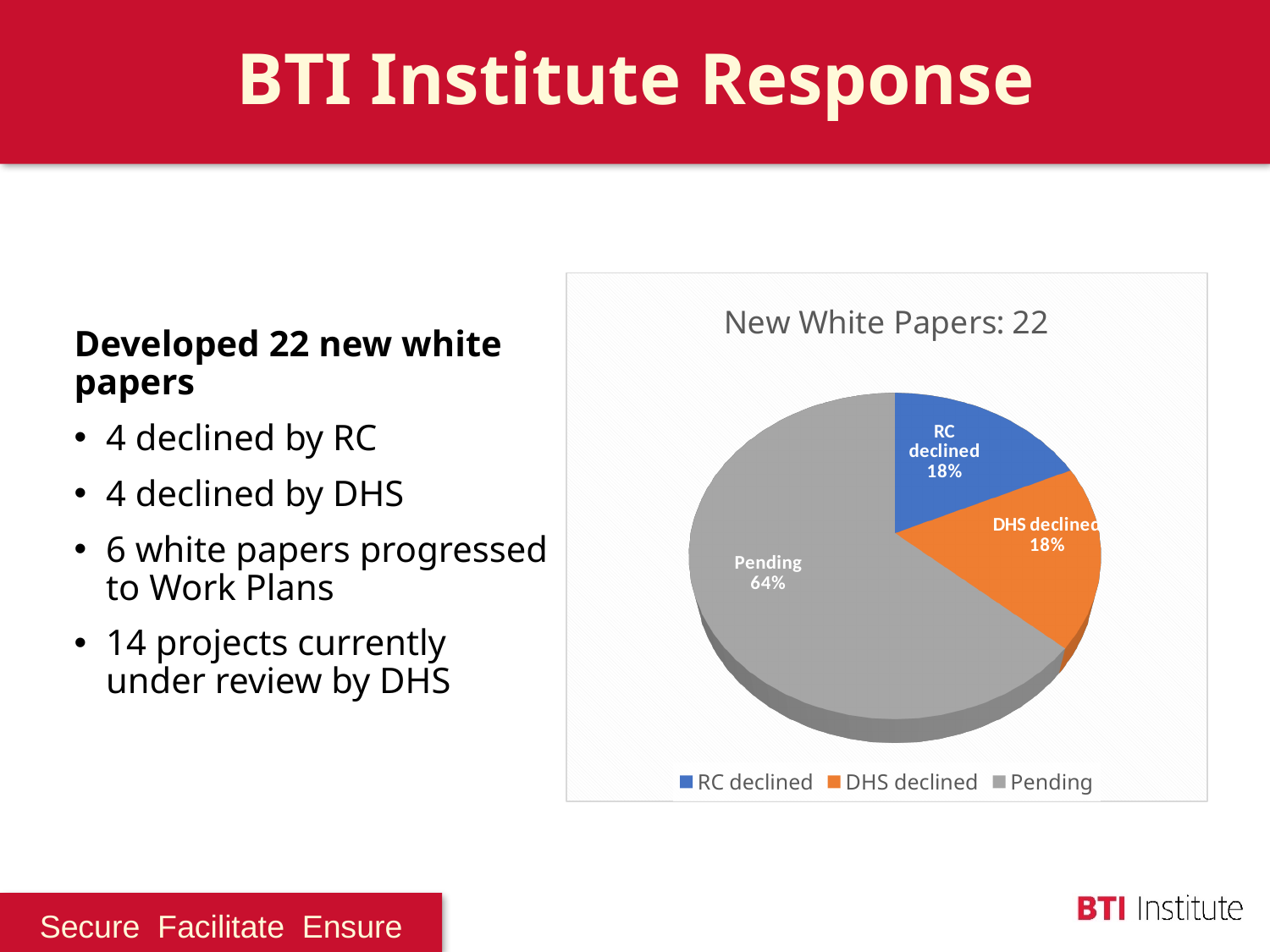
What share of the pie does the DHS declined slice represent? 18% Which category has the largest slice of the pie? Pending How many slices does the pie chart have? 3 What is the title of the chart? New White Papers: 22 Which colour represents the Pending slice in the pie chart? grey Is the Pending share greater or less than 50%? greater What kind of chart is shown on the slide? pie chart What is the difference in percentage points between the Pending slice and the RC declined slice? 46 Is the Pending slice larger or smaller than the DHS declined slice? larger What share of the pie does the RC declined slice represent? 18% How many entries does the legend list? 3 What share of the pie does the Pending slice represent? 64%